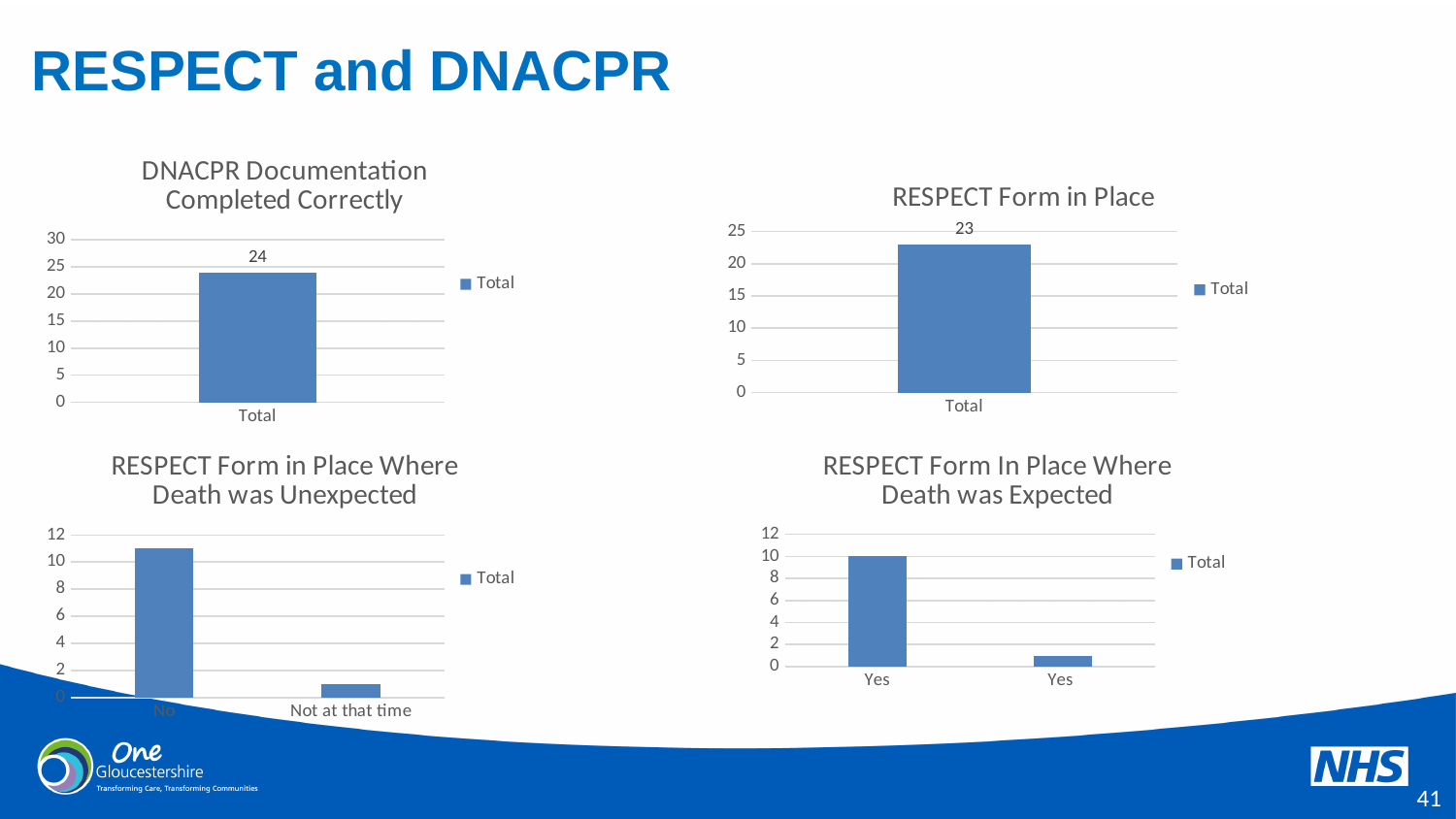
In the 'RESPECT Form in Place Where Death was Unexpected' chart, is the value for 'No' greater or less than 8? greater In the 'RESPECT Form in Place Where Death was Unexpected' chart, which category has the highest value? No In the 'DNACPR Documentation Completed Correctly' chart, what is the value of the Total bar? 24 In the 'RESPECT Form in Place Where Death was Unexpected' chart, is the value for 'Not at that time' greater or less than 2? less How many series does the legend of the 'DNACPR Documentation Completed Correctly' chart list? 1 In the 'RESPECT Form In Place Where Death was Expected' chart, which bar is taller, the left one or the right one? The left one What kind of chart is the 'RESPECT Form in Place Where Death was Unexpected' chart? Bar chart In the 'RESPECT Form In Place Where Death was Expected' chart, is the left bar greater or less than 8? greater What is the difference between the Total in the 'DNACPR Documentation Completed Correctly' chart and the Total in the 'RESPECT Form in Place' chart? 1 How many categories are shown on the x axis of the 'RESPECT Form in Place Where Death was Unexpected' chart? 2 In the 'RESPECT Form in Place' chart, what is the value of the Total bar? 23 Which is larger: the Total in the 'DNACPR Documentation Completed Correctly' chart or the Total in the 'RESPECT Form in Place' chart? DNACPR Documentation Completed Correctly